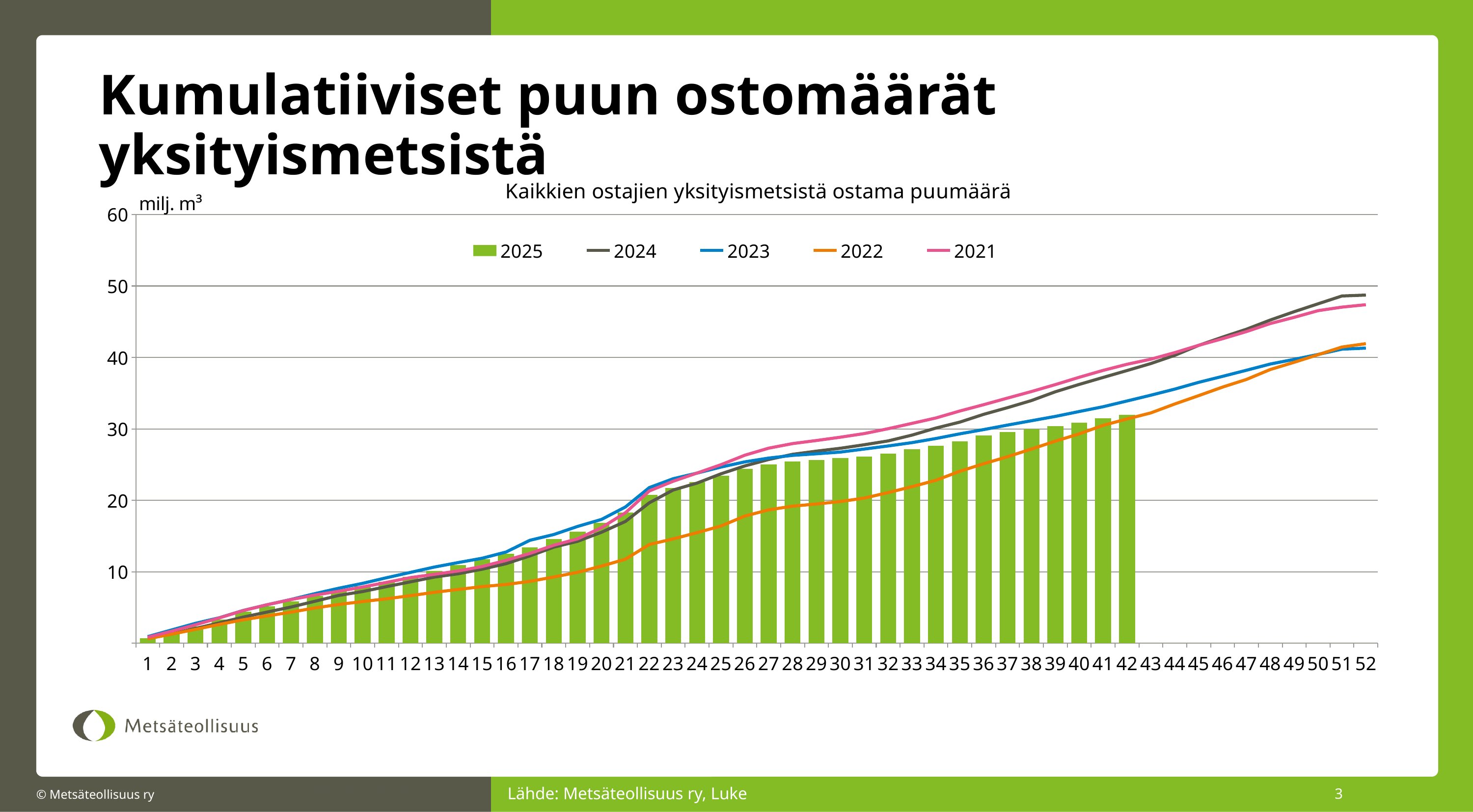
How many week categories are shown on the x axis? 52 How many series does the legend list? 5 What kind of chart is this? Combined bar and line chart What unit is shown on the y axis? milj. m³ Is the 2024 value at week 52 greater or less than 50? less Which series has the highest value at week 52? 2024 At week 52, which is larger: the 2024 value or the 2022 value? 2024 Is the 2022 value at week 26 greater or less than 20? less Which series has the lowest value at week 30? 2022 Is the 2025 value at week 42 greater or less than 30? greater Up to which week do the 2025 bars extend? 42 Do the values for each series rise or fall along the x axis? Rise